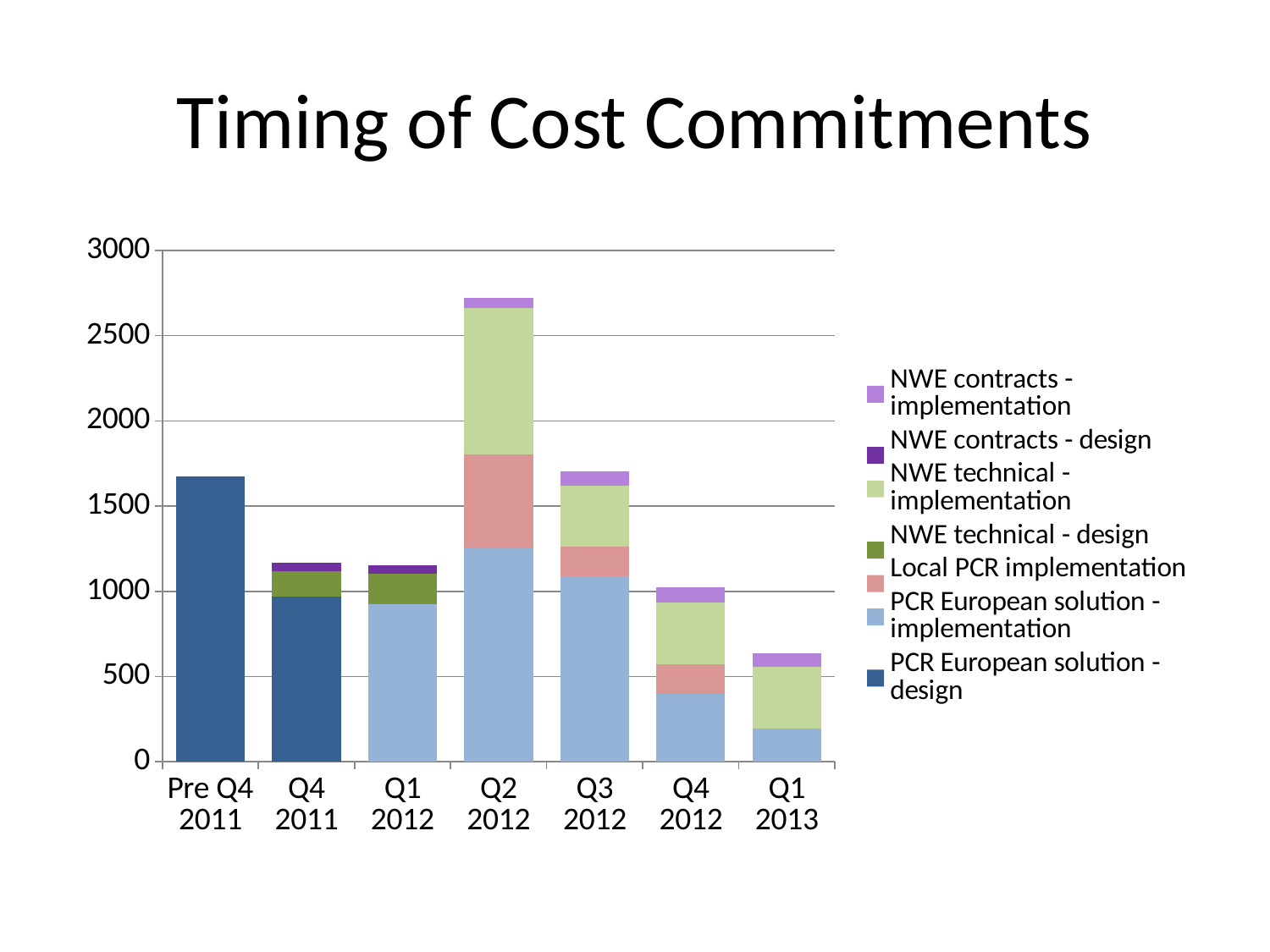
Is the total for Q2 2012 greater or less than 2500? greater Which series is shown only in the Pre Q4 2011 and Q4 2011 bars? PCR European solution - design What type of chart is shown on the slide? Stacked bar chart Which period has the tallest stacked bar? Q2 2012 Which period has the shortest stacked bar? Q1 2013 What is the title of the chart? Timing of Cost Commitments Do the stacked bar totals rise or fall from Q2 2012 to Q1 2013? fall Is the total for Pre Q4 2011 greater or less than 1500? greater How many time periods (categories) are shown on the x axis? 7 Which bar is taller, Pre Q4 2011 or Q4 2011? Pre Q4 2011 Is the total for Q1 2013 greater or less than 1000? less How many series does the legend list? 7